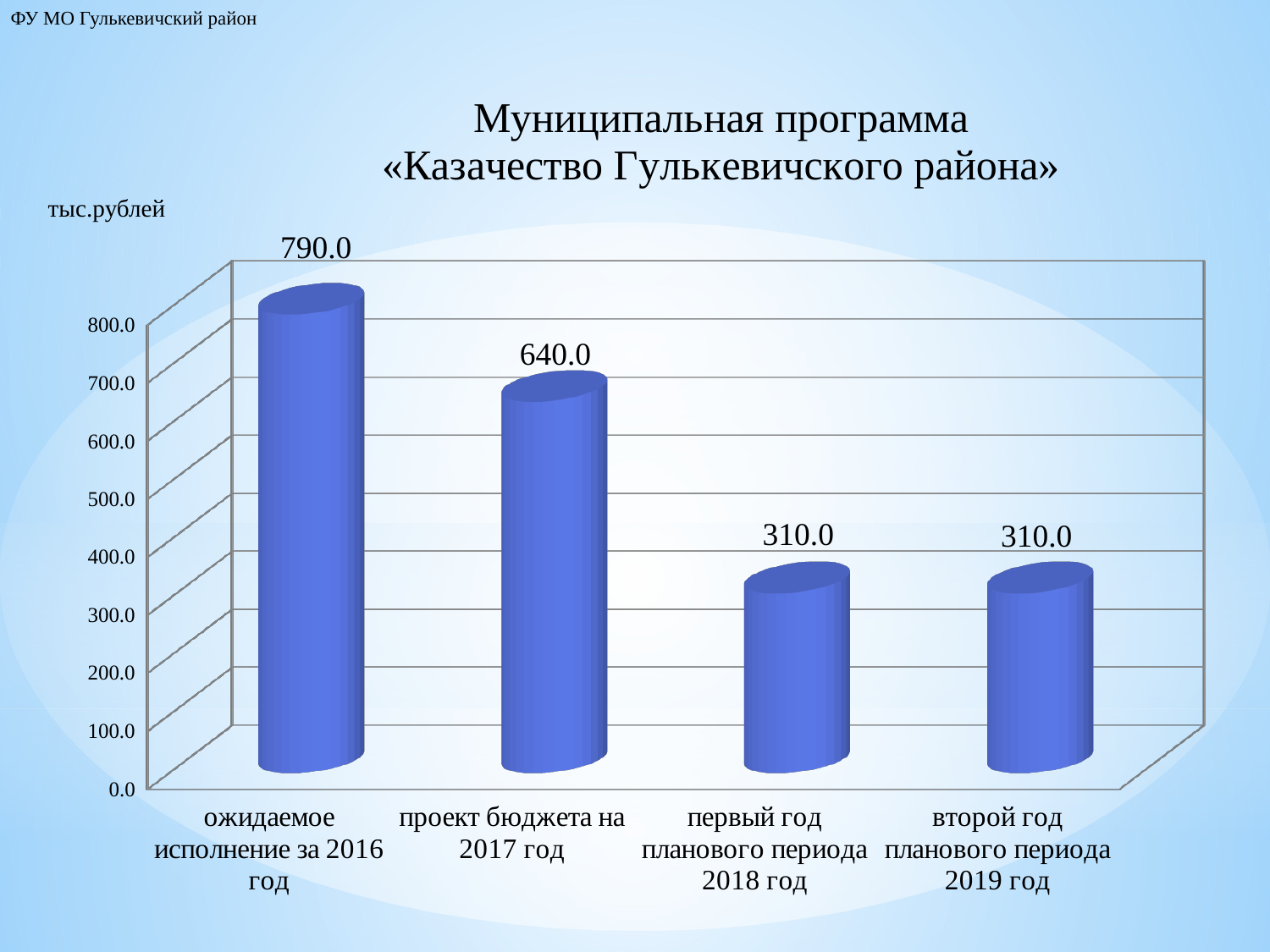
What is the difference between the values for 2016 and 2017? 150.0 What is the value for «проект бюджета на 2017 год»? 640.0 What is the value for «ожидаемое исполнение за 2016 год»? 790.0 Which is larger, the value for «проект бюджета на 2017 год» or for «второй год планового периода 2019 год»? проект бюджета на 2017 год How many categories are shown on the x axis? 4 What kind of chart is shown on the slide? bar chart Which category has the highest value? ожидаемое исполнение за 2016 год Do the values rise or fall from left to right along the x axis? fall What is the difference between the values for «проект бюджета на 2017 год» and «первый год планового периода 2018 год»? 330.0 What is the value for «первый год планового периода 2018 год»? 310.0 What unit is indicated above the chart? тыс.рублей What is the value for «второй год планового периода 2019 год»? 310.0